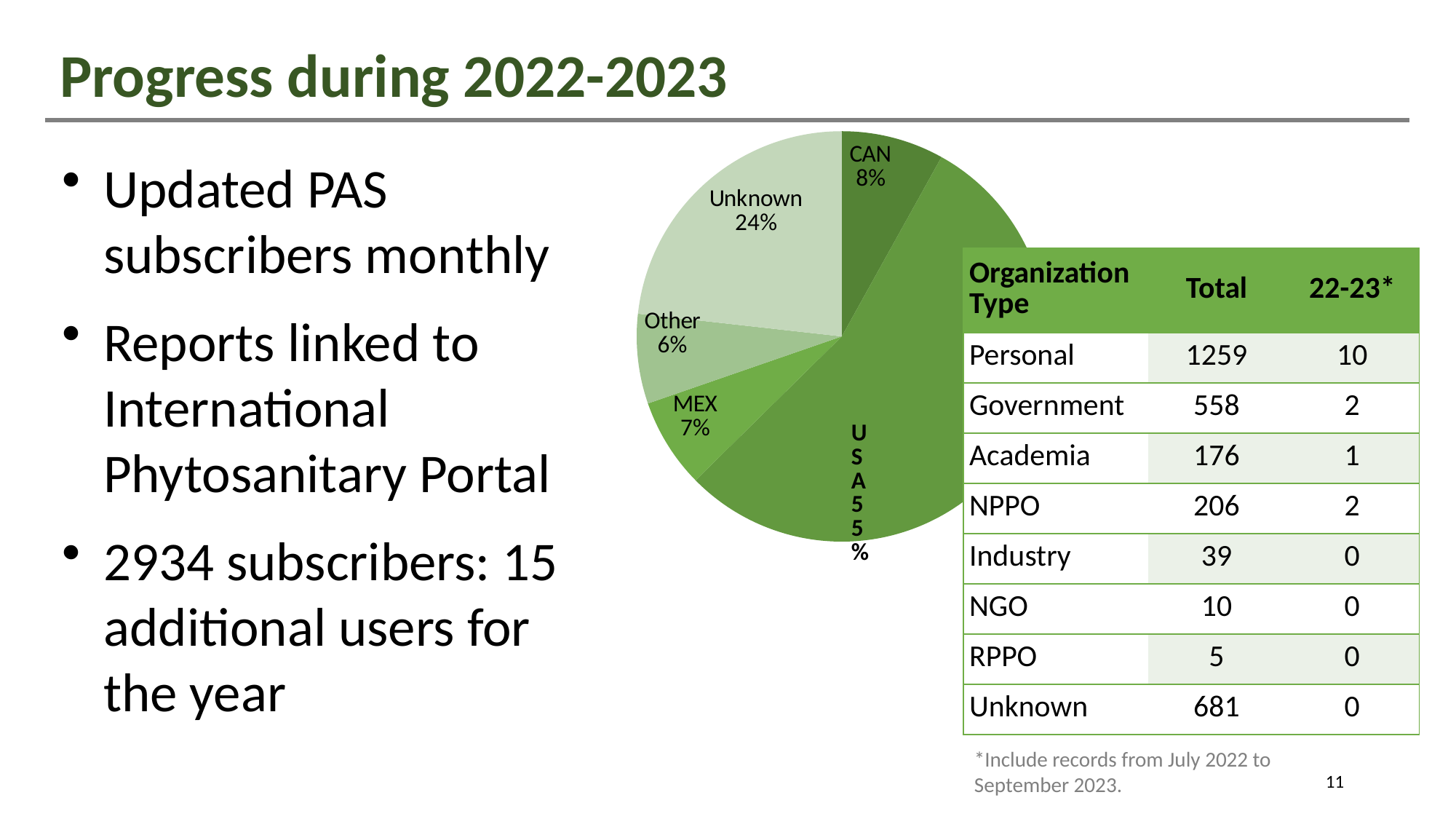
What type of chart is shown on the slide? pie chart What share of the pie chart does USA represent? 55% What is the value shown for CAN in the pie chart? 8% What is the value shown for Other in the pie chart? 6% What is the value shown for MEX in the pie chart? 7% What is the difference between the USA and Unknown shares in the pie chart? 31% What is the difference between the CAN and Other shares in the pie chart? 2% What share of the pie chart does Unknown represent? 24% How many slices does the pie chart have? 5 Which slice of the pie chart is the smallest? Other Which is larger in the pie chart, CAN or MEX? CAN Which slice of the pie chart is the largest? USA